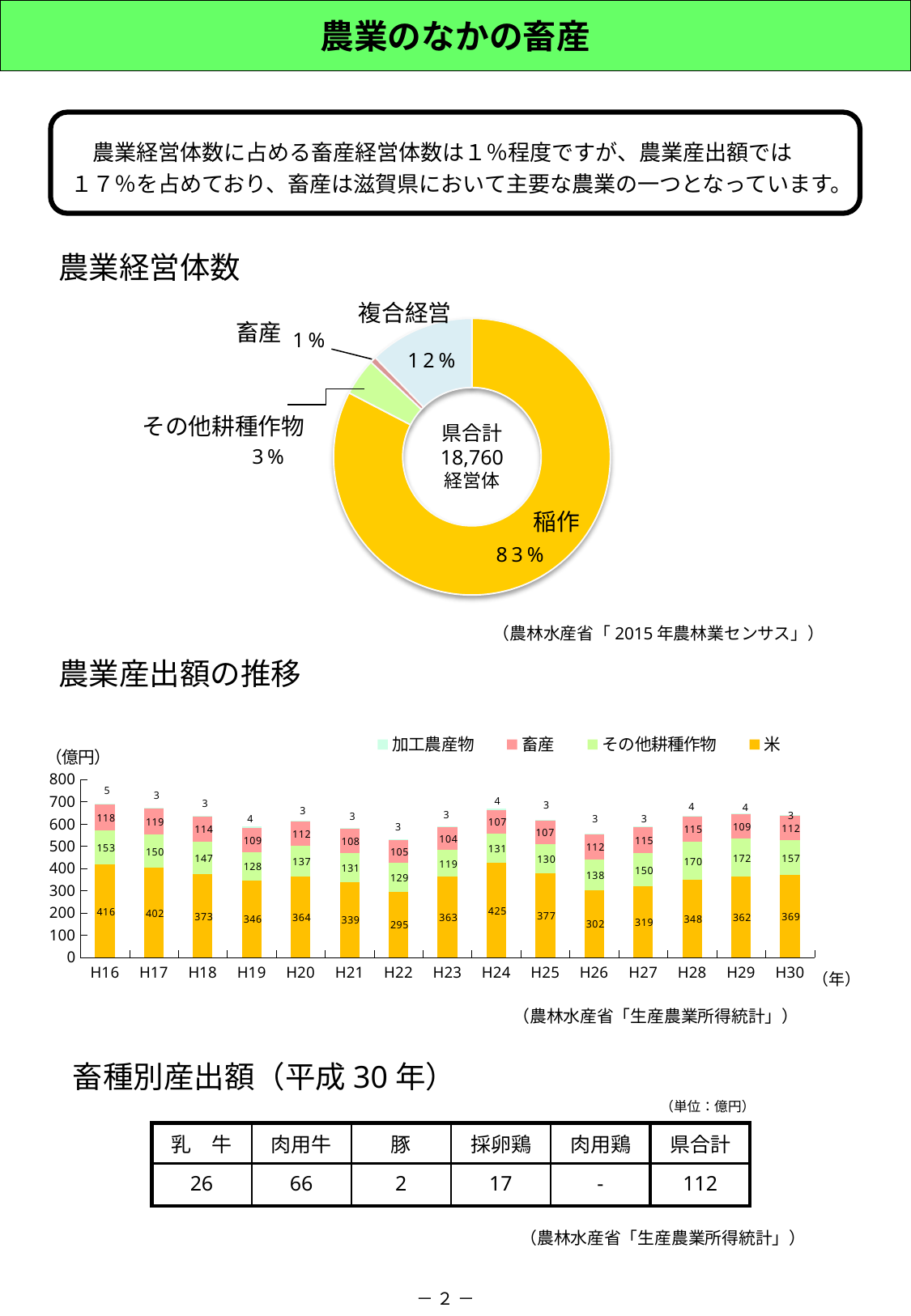
In the 農業経営体数 chart, what total number of 経営体 is shown in the centre? 18,760 In the 農業経営体数 chart, which category has the largest share? 稲作 In the 農業産出額の推移 chart, what is the value of 米 for H24? 425 In the 農業産出額の推移 chart, what is the value of 畜産 for H30? 112 In the 農業経営体数 chart, what share of the total is 畜産? 1% What kind of chart is the 農業産出額の推移 chart? Stacked bar chart In the 農業産出額の推移 chart, how many series does the legend list? 4 In the 農業経営体数 chart, what share of the total is 稲作? 83% In the 農業産出額の推移 chart, how many years are shown on the x axis? 15 In the 農業産出額の推移 chart, what is the total of the stacked bar for H30? 641 In the 農業産出額の推移 chart, what is the difference between the 米 values for H16 and H17? 14 In the 農業産出額の推移 chart, which year has the lowest value for 米? H22